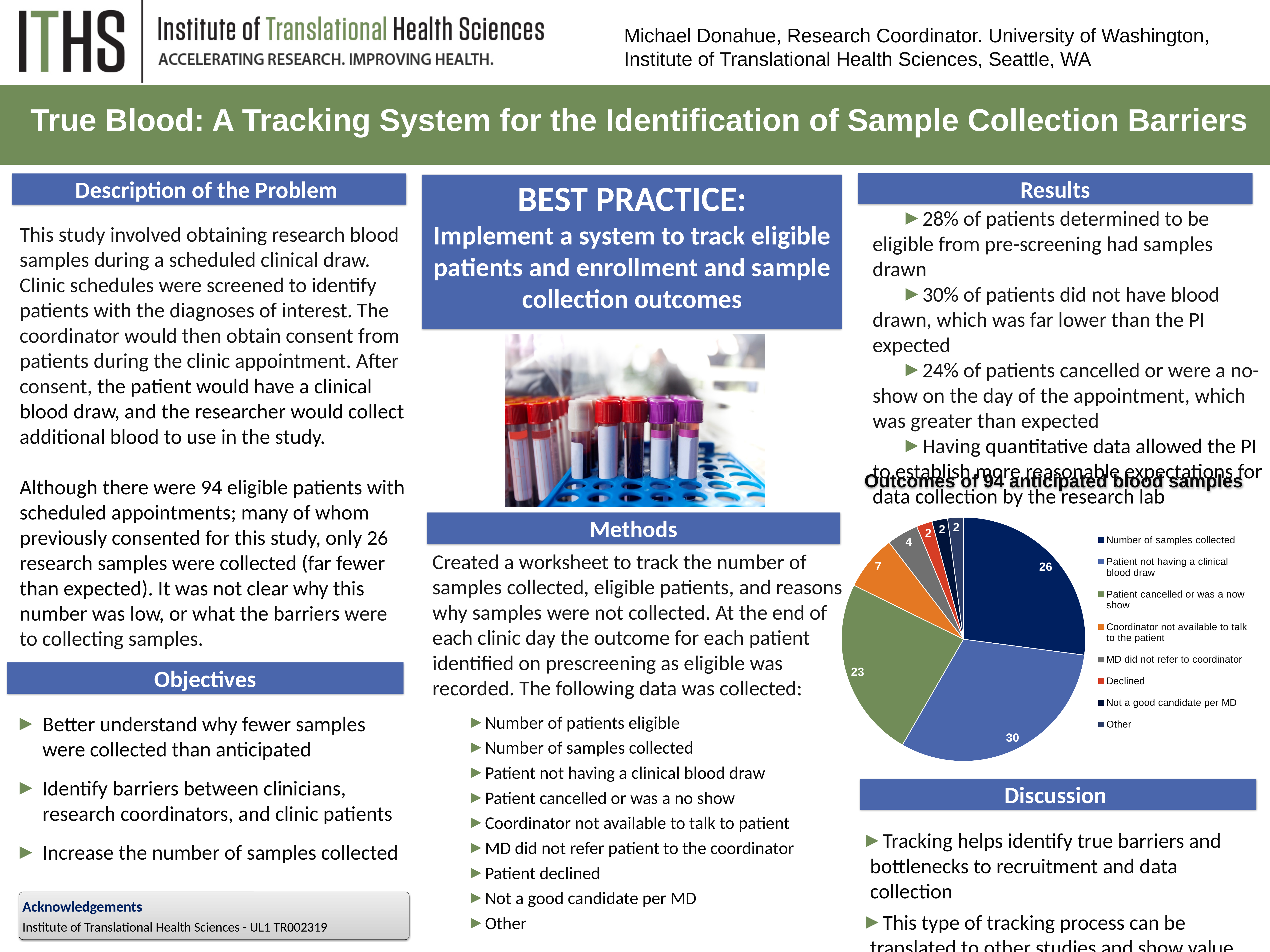
What is the difference between the values for "Coordinator not available to talk to the patient" and "MD did not refer to coordinator"? 3 What kind of chart is shown on the slide? pie chart What is the value for "Patient cancelled or was a now show"? 23 Which is larger: the value for "Patient cancelled or was a now show" or the value for "Coordinator not available to talk to the patient"? Patient cancelled or was a now show Which category has the largest slice of the pie? Patient not having a clinical blood draw What is the value for "Number of samples collected"? 26 What is the title of the chart? Outcomes of 94 anticipated blood samples How many slices does the pie chart have? 8 What is the value for "Patient not having a clinical blood draw"? 30 What is the value for "Coordinator not available to talk to the patient"? 7 What is the difference between the values for "Patient not having a clinical blood draw" and "Number of samples collected"? 4 What is the value for "MD did not refer to coordinator"? 4